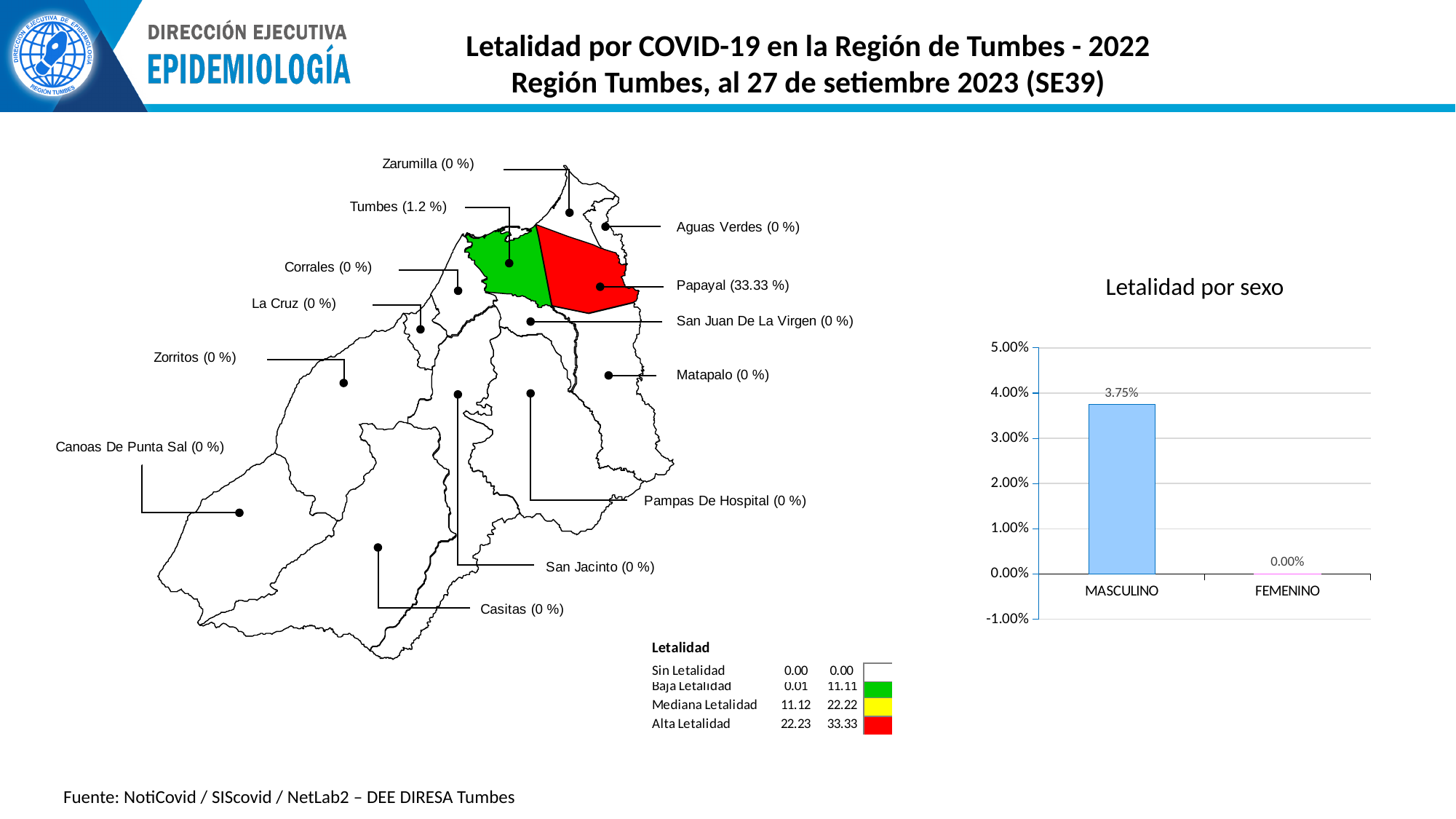
In the 'Letalidad por sexo' chart, which category has the lowest value? FEMENINO In the 'Letalidad por sexo' chart, is the value for MASCULINO greater or less than 3.00%? greater In the 'Letalidad por sexo' chart, what is the value for MASCULINO? 3.75% In the 'Letalidad por sexo' chart, what is the difference between the MASCULINO and FEMENINO values? 3.75% In the 'Letalidad por sexo' chart, which is larger, the value for MASCULINO or for FEMENINO? MASCULINO How many categories are shown in the 'Letalidad por sexo' chart? 2 What kind of chart is the 'Letalidad por sexo' chart? bar chart In the 'Letalidad por sexo' chart, what is the highest value shown on the vertical axis? 5.00% In the 'Letalidad por sexo' chart, is the value for MASCULINO greater or less than 4.00%? less In the 'Letalidad por sexo' chart, what is the value for FEMENINO? 0.00% What is the title of the chart on the right side of the slide? Letalidad por sexo In the 'Letalidad por sexo' chart, which category has the highest value? MASCULINO